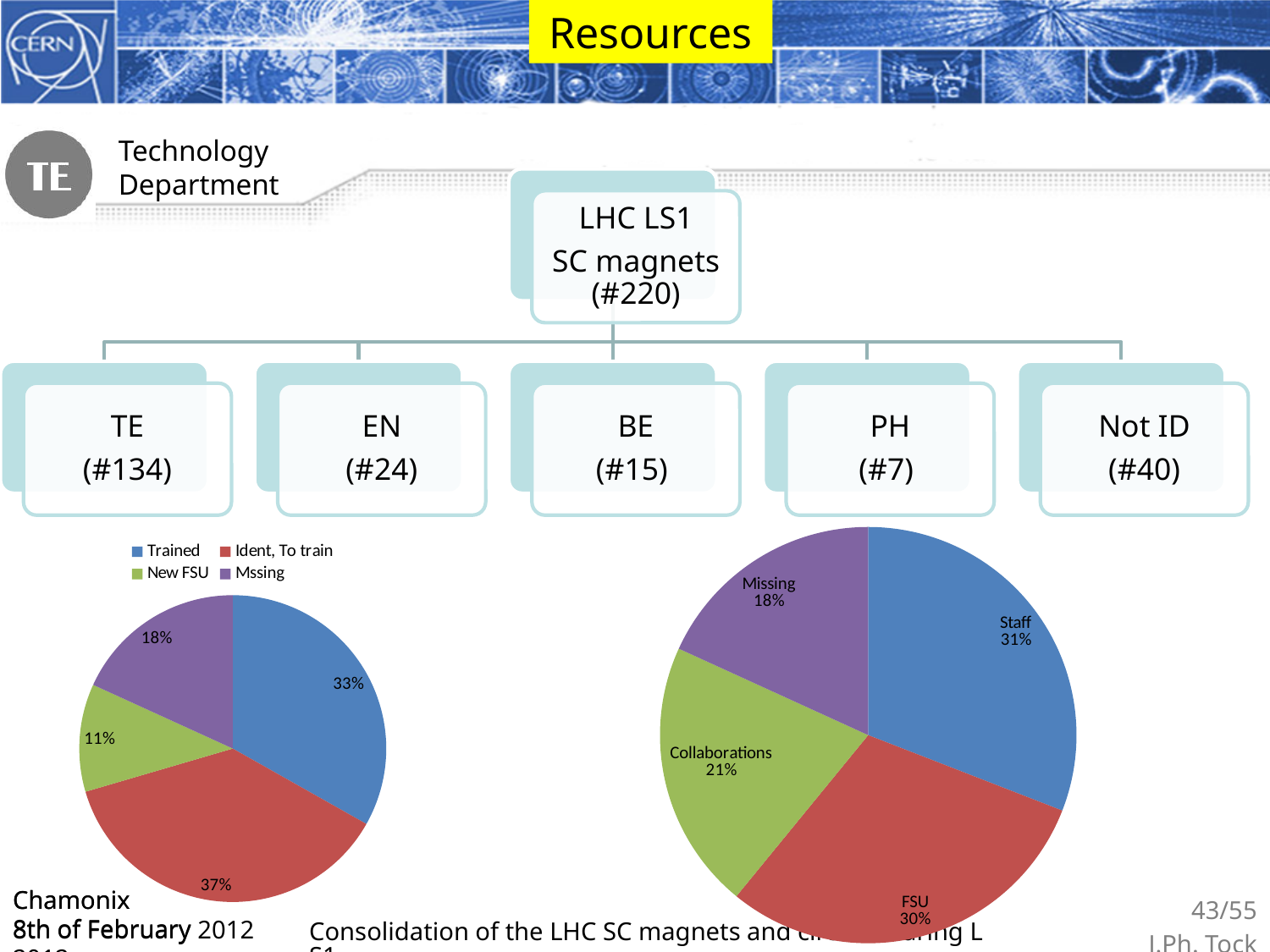
What type of chart is the right chart on the slide? Pie chart On the left pie chart, what share is shown for New FSU? 11% On the right pie chart, what share is shown for Staff? 31% On the right pie chart, what share is shown for Missing? 18% On the right pie chart, which category has the smallest share? Missing On the left pie chart, which category has the largest share? Ident, To train On the left pie chart, what share is shown for Trained? 33% On the left pie chart, how many categories does the legend list? 4 On the right pie chart, what share is shown for Collaborations? 21% On the right pie chart, what is the difference between the Staff share and the Collaborations share? 10% On the left pie chart, which category has the smallest share? New FSU On the left pie chart, what share is shown for Ident, To train? 37%